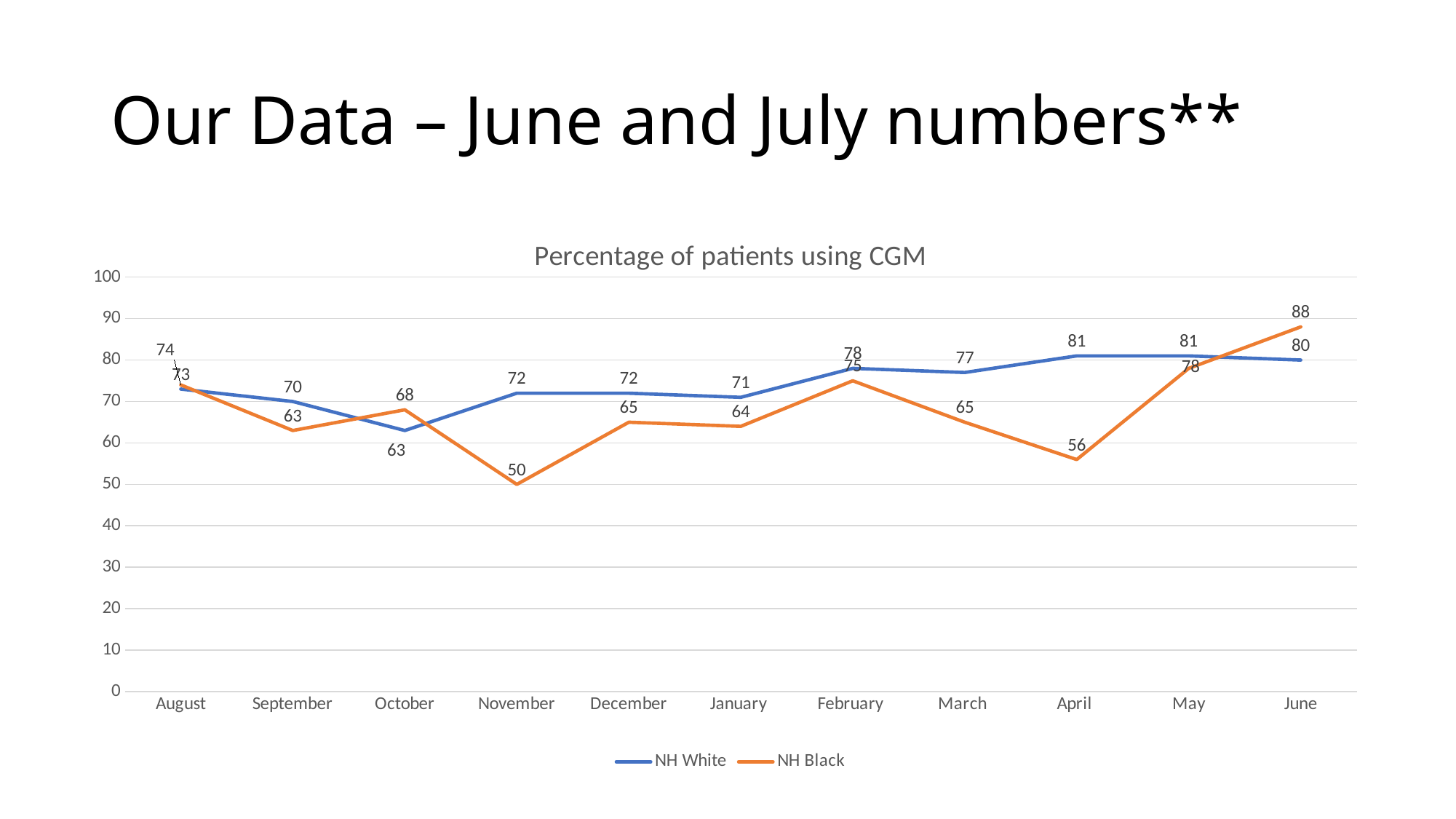
In which month is the NH White value lowest? October How many months are plotted along the x axis? 11 What kind of chart is shown on the slide? line chart In April, which series has the larger value, NH White or NH Black? NH White In which month is the NH Black value lowest? November What is the title of the chart? Percentage of patients using CGM What is the value for NH Black in June? 88 What is the value for NH White in April? 81 What is the value for NH Black in November? 50 How many series does the legend list? 2 In which month is the NH Black value highest? June What is the difference between NH Black and NH White in June? 8